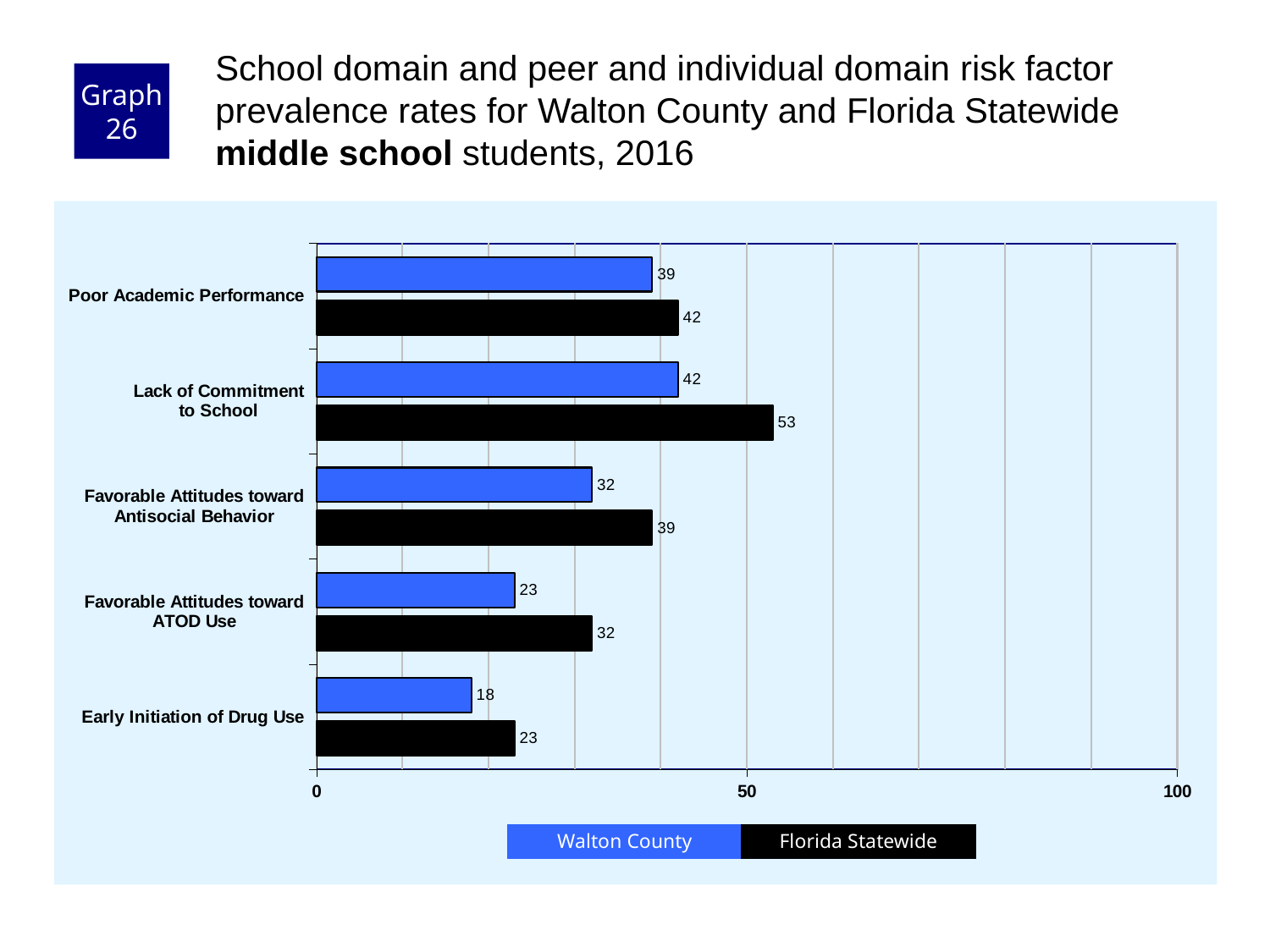
What is the difference between the Florida Statewide and Walton County values for Lack of Commitment to School? 11 What is the Florida Statewide value for Lack of Commitment to School? 53 What is the Florida Statewide value for Favorable Attitudes toward ATOD Use? 32 How many series does the legend list? 2 Is the Florida Statewide value for Lack of Commitment to School greater or less than 50? greater How many risk factors are shown on the chart? 5 What is the Walton County value for Poor Academic Performance? 39 What is the Walton County value for Early Initiation of Drug Use? 18 Which risk factor has the highest Florida Statewide value? Lack of Commitment to School Which is larger for Favorable Attitudes toward Antisocial Behavior: the Walton County value or the Florida Statewide value? Florida Statewide What kind of chart is shown on the slide? bar chart Which risk factor has the lowest Walton County value? Early Initiation of Drug Use